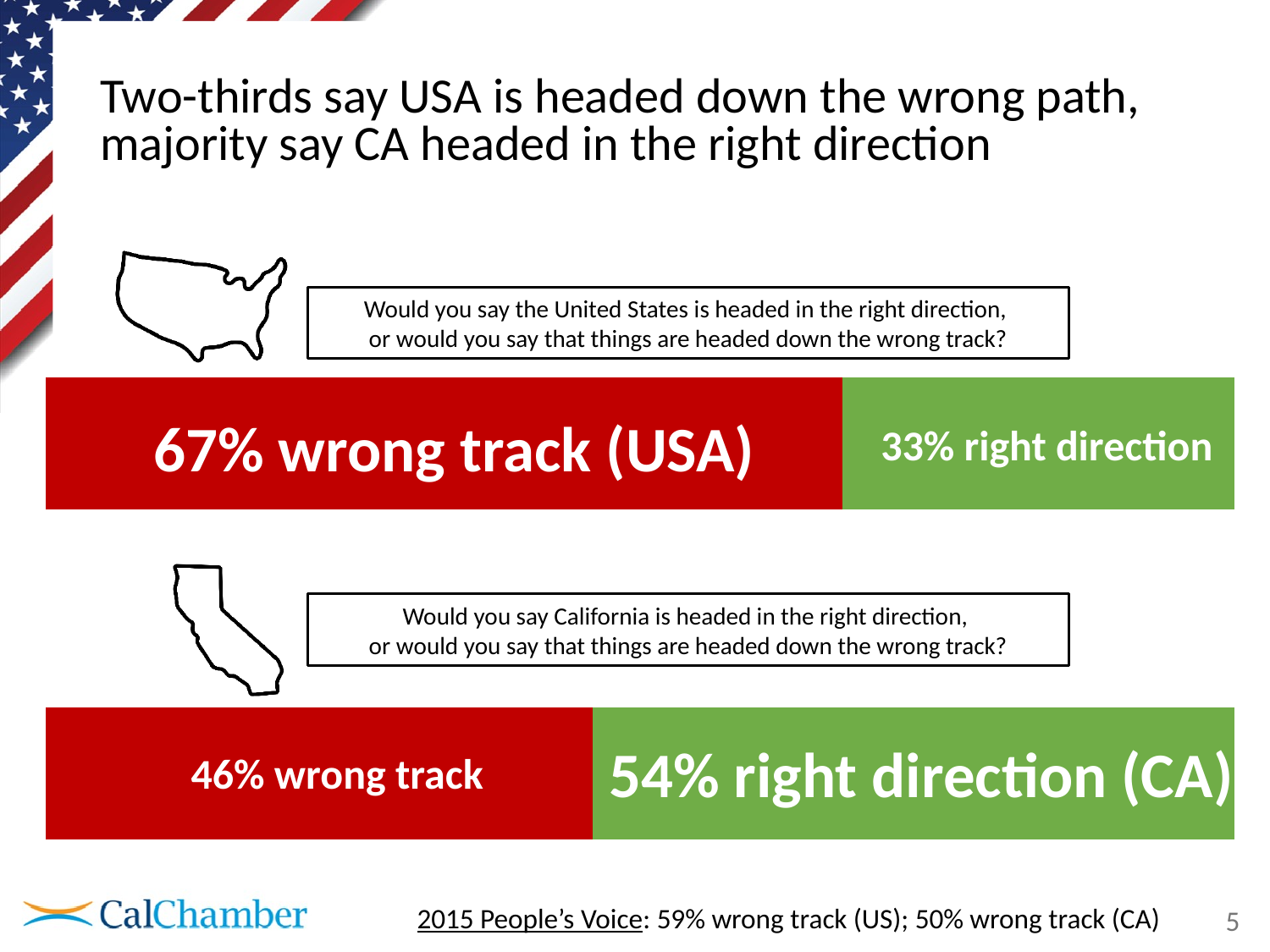
In the USA bar, what is the difference between the wrong track and right direction percentages? 34% In the California bar, what percentage say California is headed down the wrong track? 46% Which has the higher wrong track percentage, the USA bar or the California bar? USA What colour is used for the wrong track segment in both bars? Red Which is larger in the California bar: wrong track or right direction? right direction In the USA bar, what percentage say the United States is headed down the wrong track? 67% In the USA bar, what percentage say the United States is headed in the right direction? 33% In the California bar, what percentage say California is headed in the right direction? 54% What is the total of the two segments in the USA bar? 100% In the California bar, what is the difference between the right direction and wrong track percentages? 8% According to the footnote, what was the wrong track percentage for the US in the 2015 People's Voice survey? 59% Which is larger in the USA bar: wrong track or right direction? wrong track